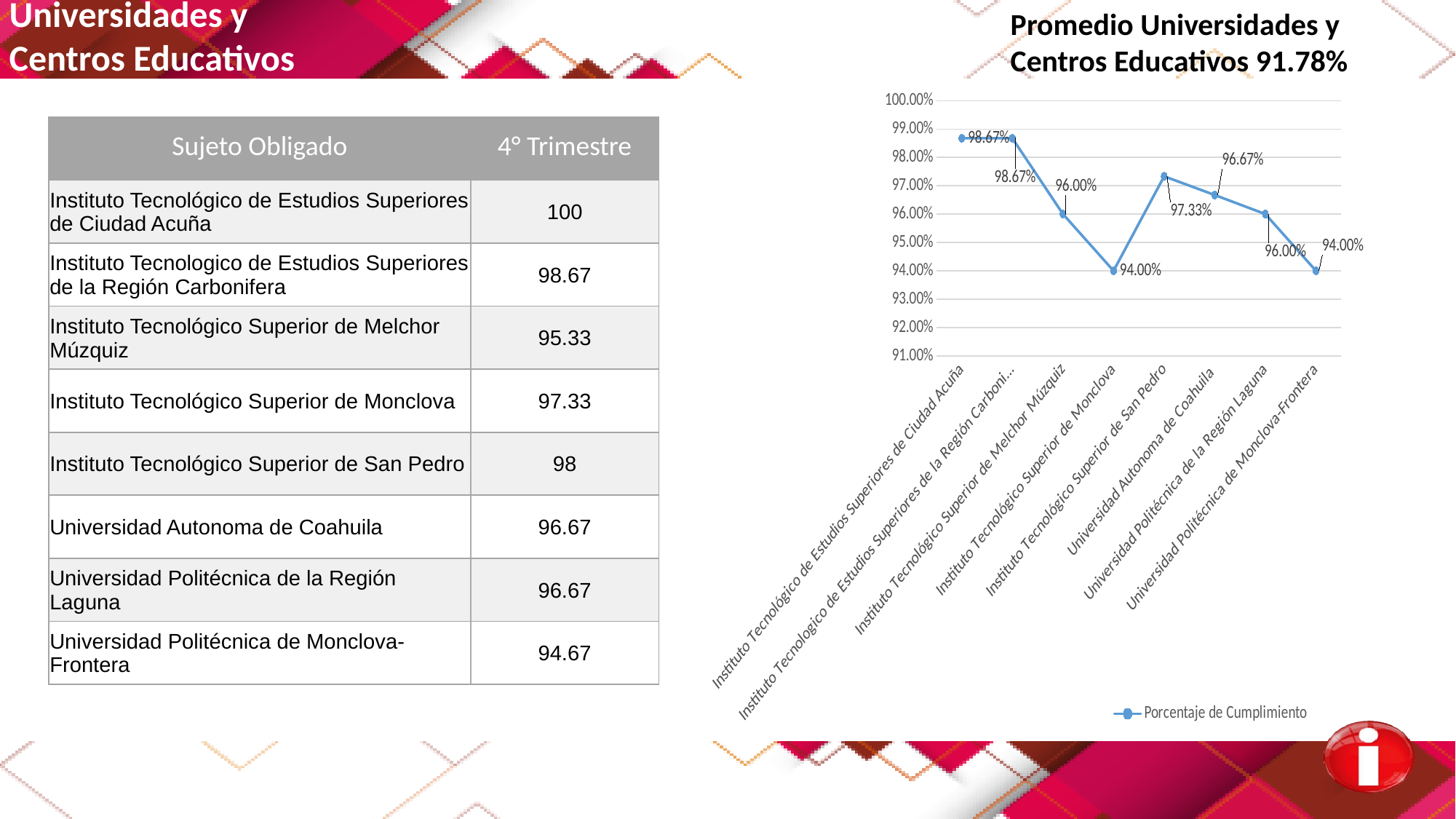
What is the value plotted for Instituto Tecnológico Superior de Melchor Múzquiz? 96.00% How many series does the chart legend list? 1 What type of chart is shown on the slide? Line chart How many categories are plotted on the x axis of the chart? 8 What is the name of the series shown in the chart legend? Porcentaje de Cumplimiento Which has the larger value, Universidad Autonoma de Coahuila or Universidad Politécnica de la Región Laguna? Universidad Autonoma de Coahuila Is the value for Instituto Tecnológico de Estudios Superiores de Ciudad Acuña greater or less than 98.00%? greater What is the value plotted for Instituto Tecnológico Superior de Monclova? 94.00% What is the difference between the values for Instituto Tecnológico Superior de San Pedro and Instituto Tecnológico Superior de Monclova? 3.33% What is the value plotted for Universidad Autonoma de Coahuila? 96.67% What is the value plotted for Instituto Tecnológico Superior de San Pedro? 97.33% What is the value plotted for Universidad Politécnica de Monclova-Frontera? 94.00%